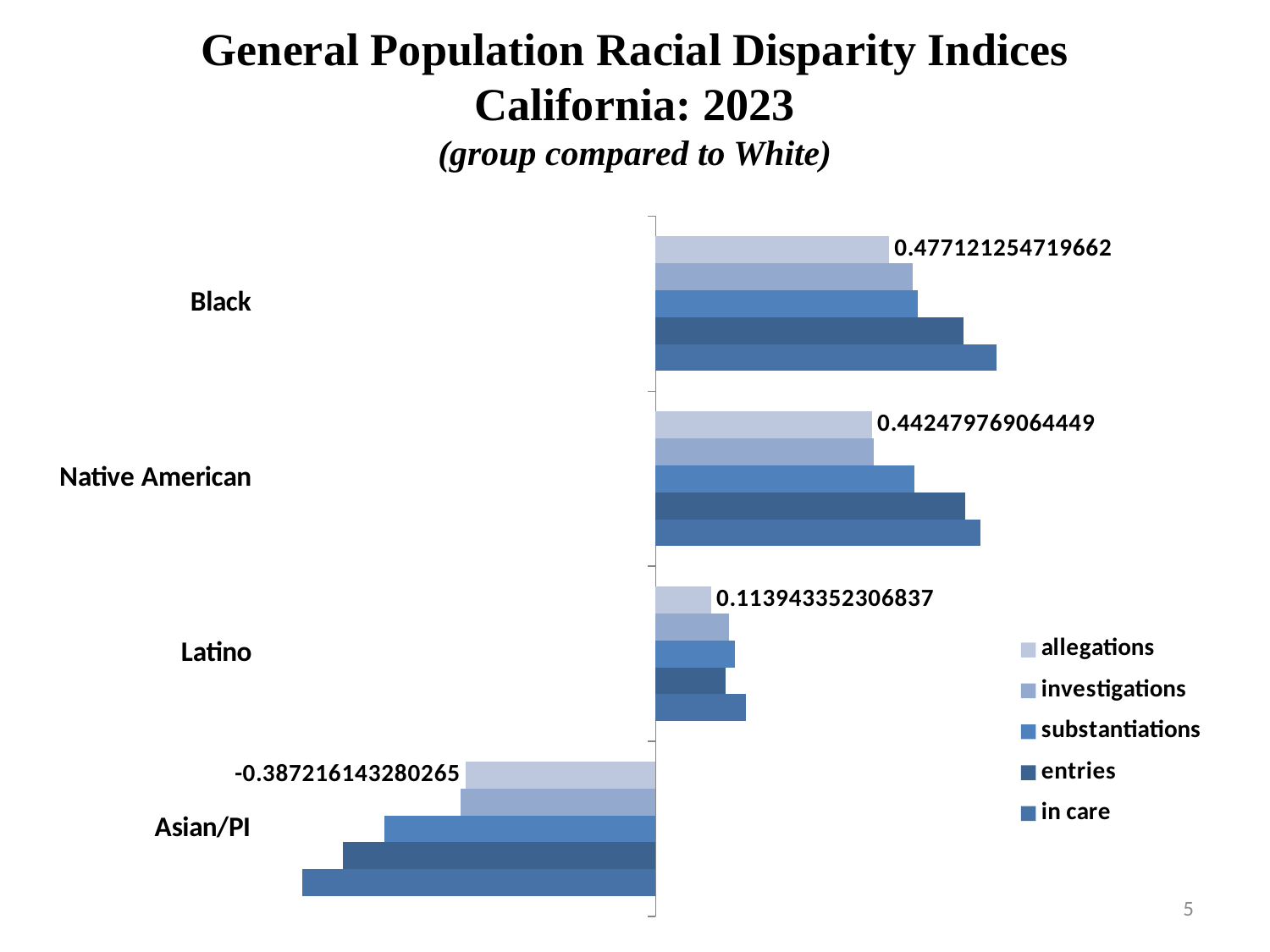
Which group is the only one with negative disparity indices across all series? Asian/PI Which group has the lowest allegations disparity index? Asian/PI What kind of chart is shown on the slide? Bar chart What is the allegations disparity index value shown for Asian/PI? -0.387216143280265 What is the allegations disparity index value shown for Black? 0.477121254719662 What is the allegations disparity index value shown for Latino? 0.113943352306837 Which is larger, the allegations value for Black or for Latino? Black What is the difference between the allegations values for Black and Native American? 0.034641485655213 What is the allegations disparity index value shown for Native American? 0.442479769064449 How many series does the legend list? 5 Which group has the highest allegations disparity index? Black How many racial groups are shown on the chart? 4